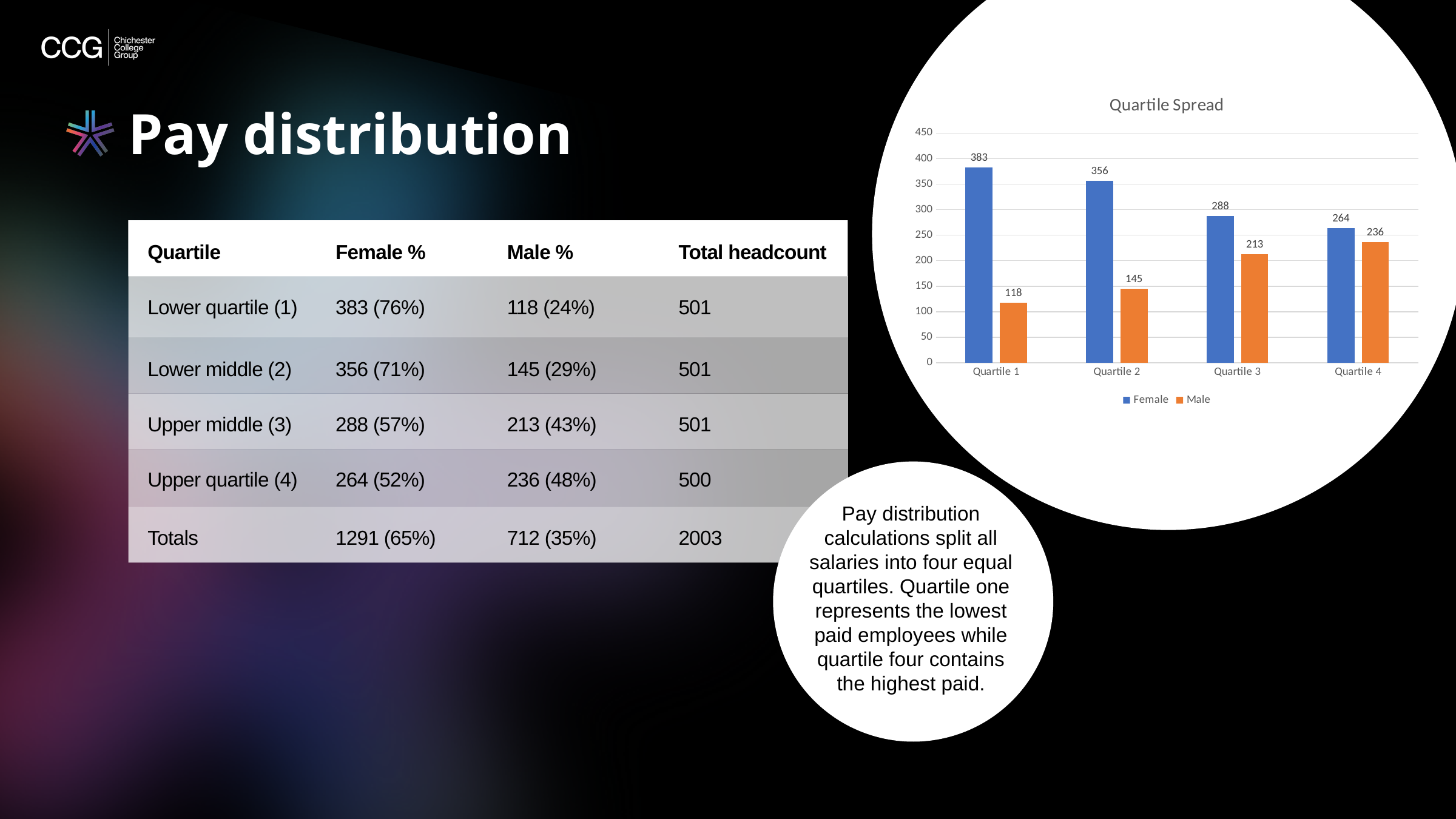
Is the Male value for Quartile 3 in the Quartile Spread chart greater or less than 200? greater What is the Male value for Quartile 4 in the Quartile Spread chart? 236 In the Quartile Spread chart, is the Female value for Quartile 2 larger or the Male value for Quartile 4? Female value for Quartile 2 What is the difference between the Female and Male values for Quartile 3 in the Quartile Spread chart? 75 What is the Female value for Quartile 1 in the Quartile Spread chart? 383 Do the Female values rise or fall from Quartile 1 to Quartile 4 in the Quartile Spread chart? Fall How many quartile categories are shown on the x axis of the Quartile Spread chart? 4 Which quartile has the lowest Male value in the Quartile Spread chart? Quartile 1 What is the Male value for Quartile 2 in the Quartile Spread chart? 145 Which quartile has the highest Female value in the Quartile Spread chart? Quartile 1 What kind of chart is the Quartile Spread chart? Bar chart How many series does the legend of the Quartile Spread chart list? 2